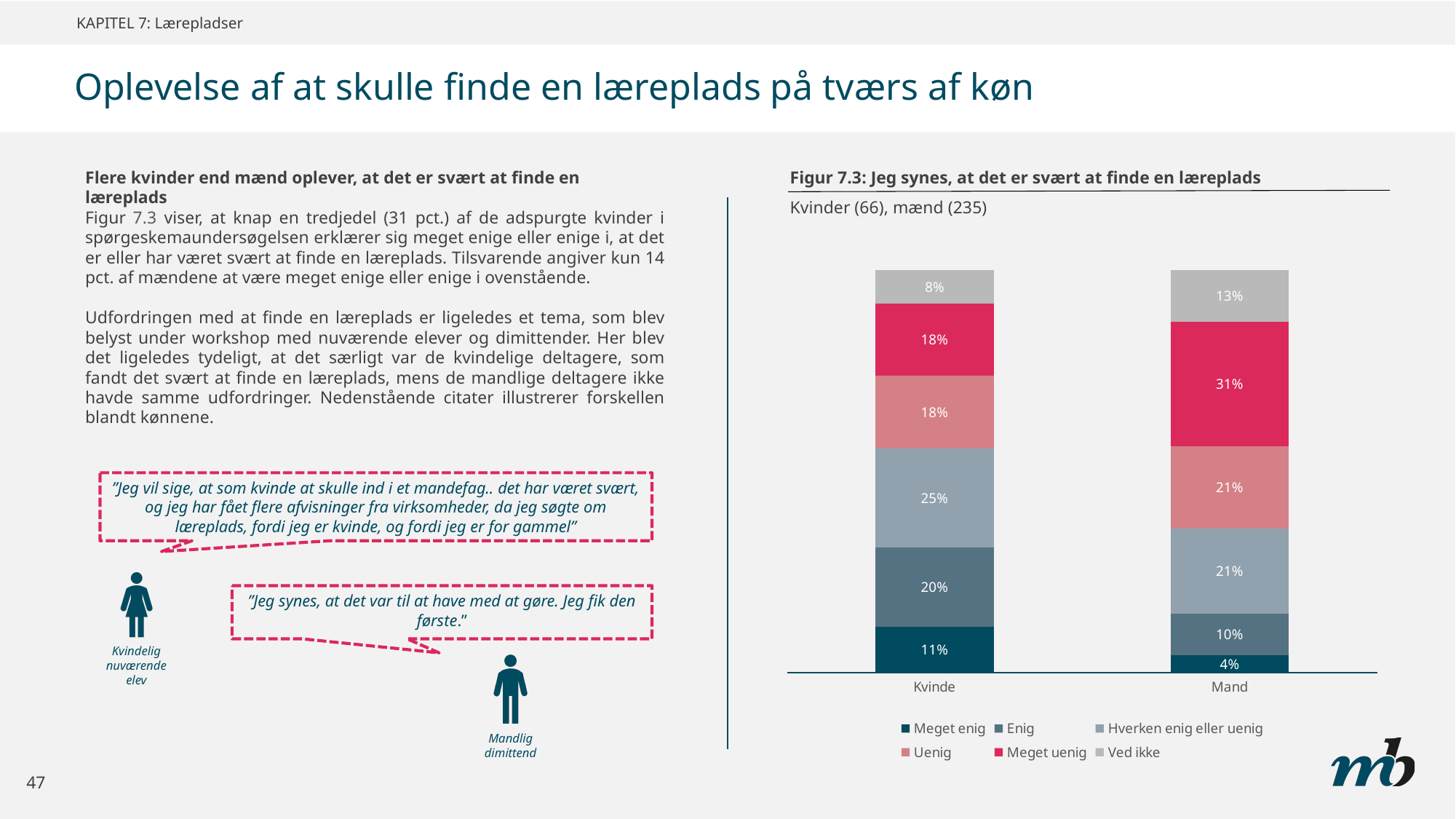
Which segment is the smallest in the Kvinde bar? Ved ikke What is the total of the Kvinde stacked bar? 100% Which category has the larger "Meget enig" value, Kvinde or Mand? Kvinde How many categories are shown on the x axis? 2 Which segment is the largest in the Mand bar? Meget uenig What is the value for "Meget uenig" in the Mand bar? 31% What is the value for "Meget enig" in the Kvinde bar? 11% What is the value for "Ved ikke" in the Mand bar? 13% What is the difference between the "Enig" values for Kvinde and Mand? 10% What is the value for "Hverken enig eller uenig" in the Kvinde bar? 25% How many series does the legend list? 6 What type of chart is shown in Figur 7.3? Stacked bar chart